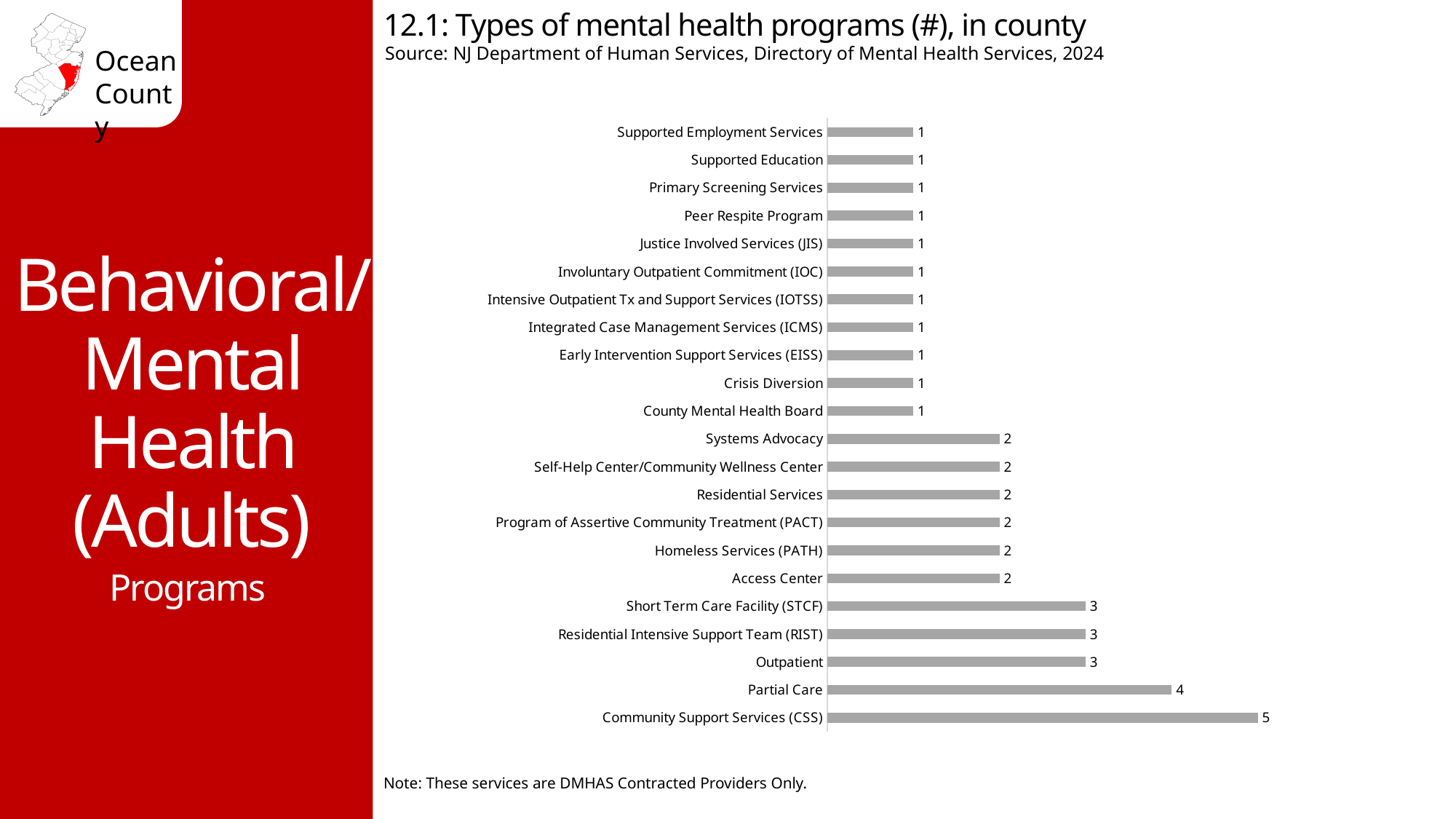
What is the difference between Short Term Care Facility (STCF) and Supported Education? 2 What is the value for Outpatient? 3 What type of chart is shown? Bar chart What is the value for Community Support Services (CSS)? 5 What is the value for Homeless Services (PATH)? 2 What is the value for Partial Care? 4 Which category has the highest value? Community Support Services (CSS) What is the difference between Community Support Services (CSS) and Partial Care? 1 What is the value for Crisis Diversion? 1 Which is larger, Partial Care or Outpatient? Partial Care How many categories are shown in the chart? 22 What is the title of the chart? 12.1: Types of mental health programs (#), in county